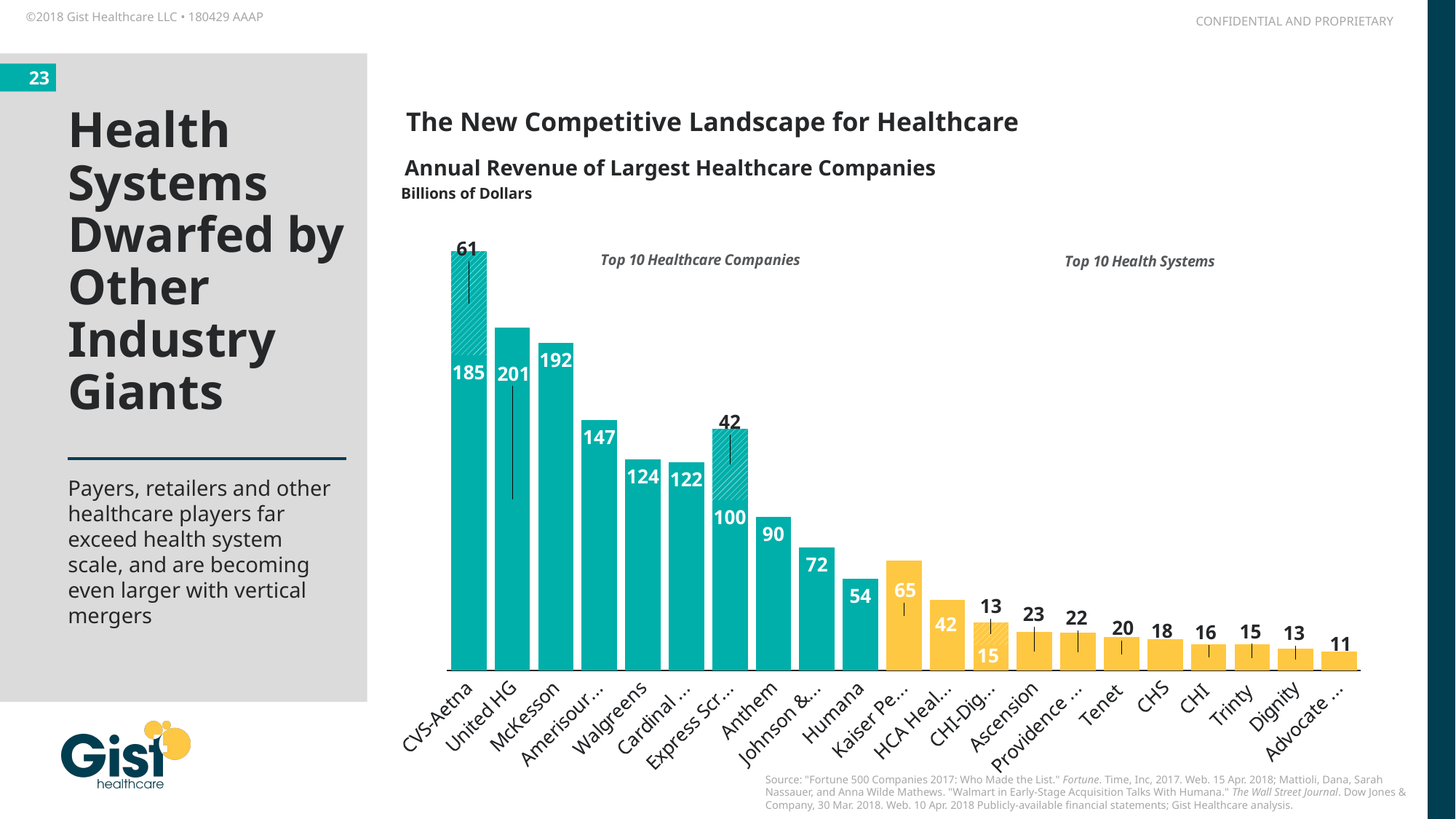
Which has a larger value, Tenet or CHS? Tenet What kind of chart is shown on the slide? bar chart What is the total of the stacked bar for CVS-Aetna? 246 What unit is stated for the values in the chart? Billions of Dollars What is the difference between the values for United HG and McKesson? 9 Which company has the tallest bar in the chart? CVS-Aetna What is the annual revenue shown for Walgreens? 124 What is the annual revenue shown for Ascension? 23 Which has a larger value, Anthem or Humana? Anthem What is the annual revenue shown for McKesson? 192 How many companies are shown along the x axis of the chart? 21 What is the difference between the values for Walgreens and Humana? 70